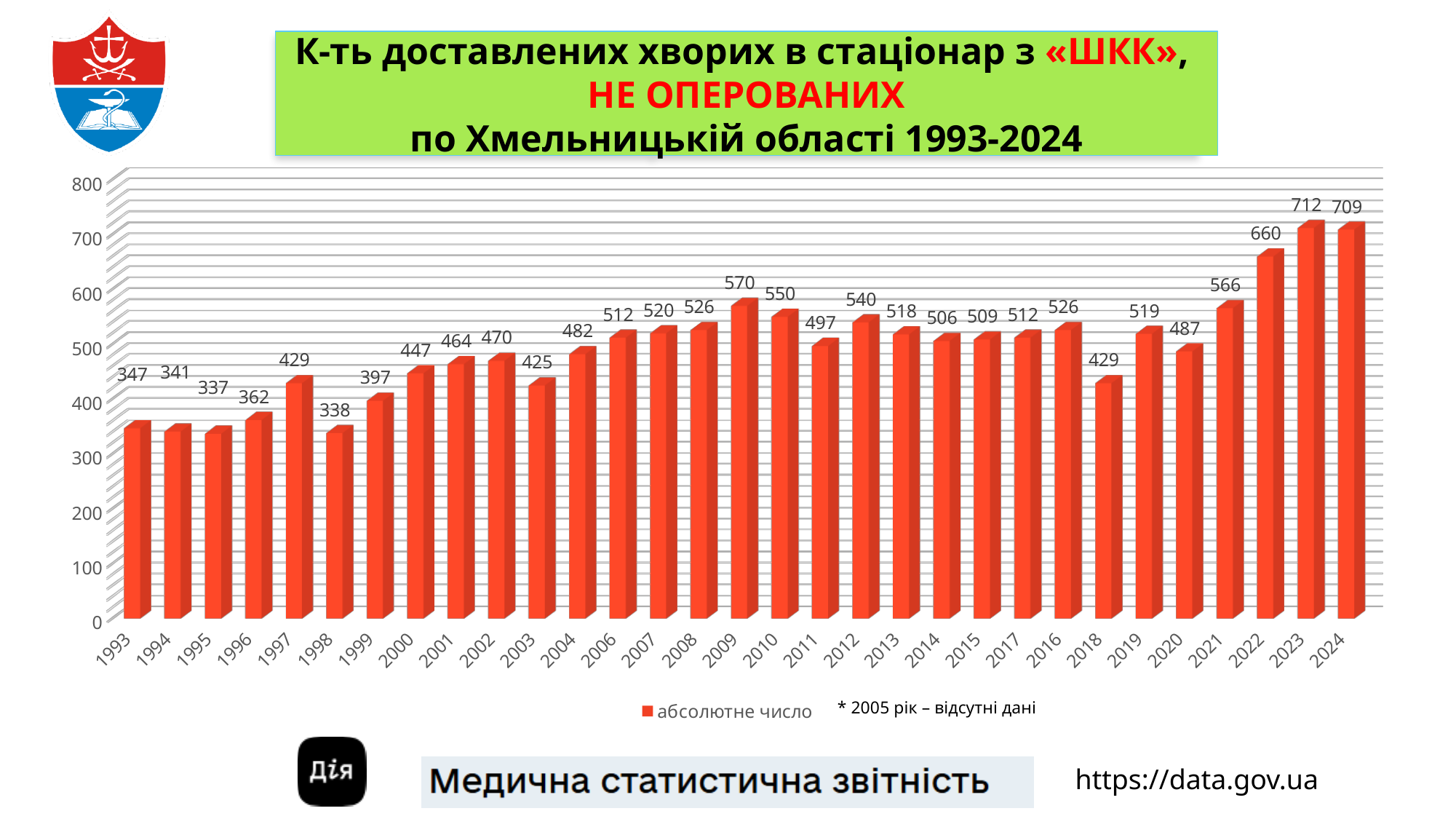
How many years (bars) are shown on the chart? 31 What is the difference between the values for 2023 and 2022? 52 What kind of chart is shown on the slide? bar chart How many series does the legend list? 1 Which is larger, the value for 2010 or the value for 2011? 2010 What is the value for 2009? 570 What is the value for 2022? 660 Which year has the lowest value? 1995 What is the difference between the values for 2024 and 1993? 362 Do the values generally rise or fall from 1993 to 2024? rise Which year has the highest value? 2023 What is the value for 2018? 429